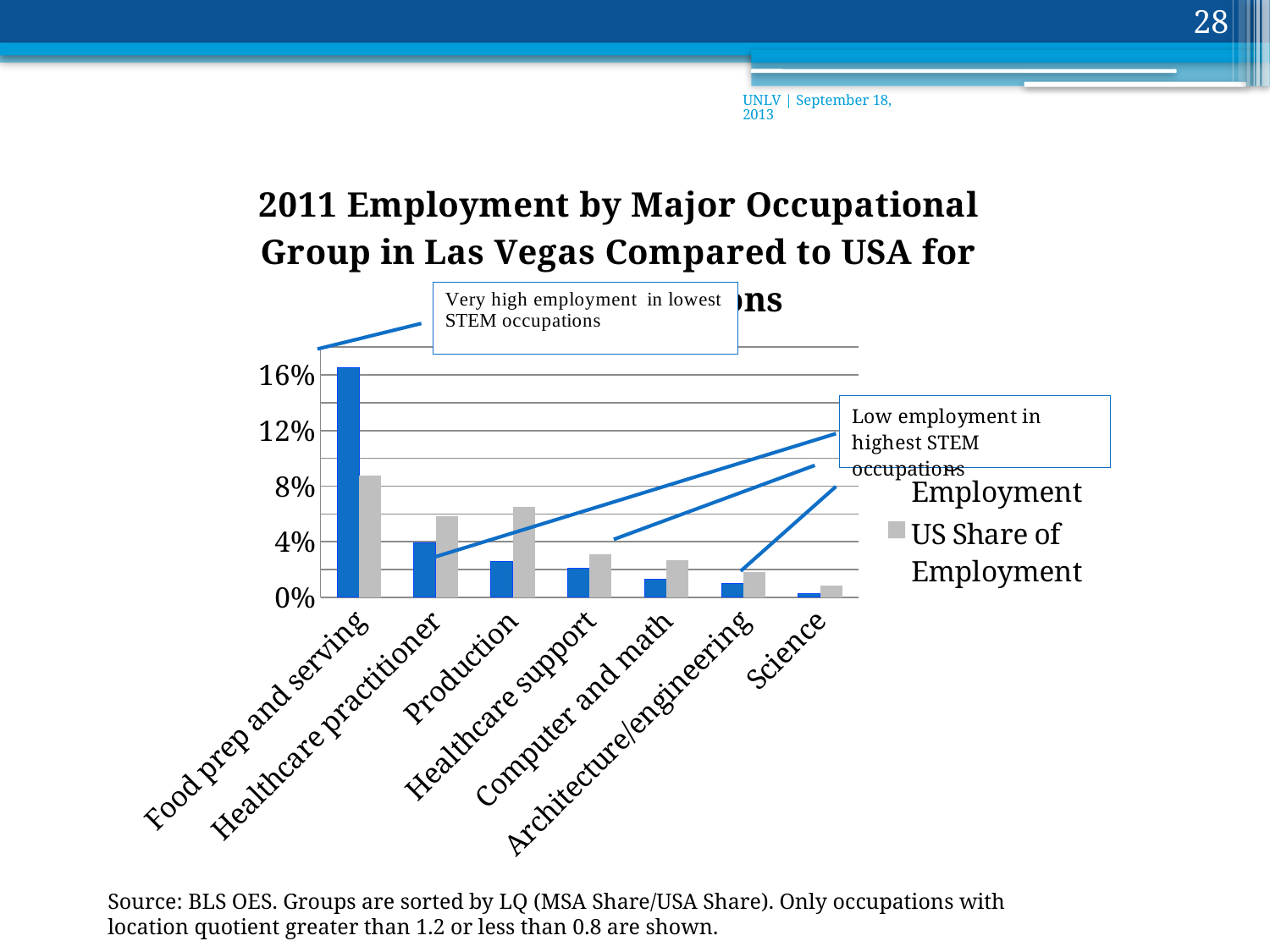
Is the blue (Las Vegas) bar for Food prep and serving greater or less than 12%? greater Do the blue (Las Vegas) bars rise or fall moving from left to right along the x axis? fall Which occupational group has the highest value for the blue (Las Vegas) bars? Food prep and serving Which occupational group has the lowest value for the blue (Las Vegas) bars? Science What kind of chart is shown on the slide? bar chart Which occupational group has the lowest US Share of Employment? Science Is the blue (Las Vegas) bar for Production greater or less than 4%? less Is the US Share of Employment for Food prep and serving greater or less than 8%? greater How many occupational groups are shown on the x axis of the chart? 7 How many series does the chart's legend list? 2 For Production, which is larger: the blue (Las Vegas) bar or the US Share of Employment bar? US Share of Employment